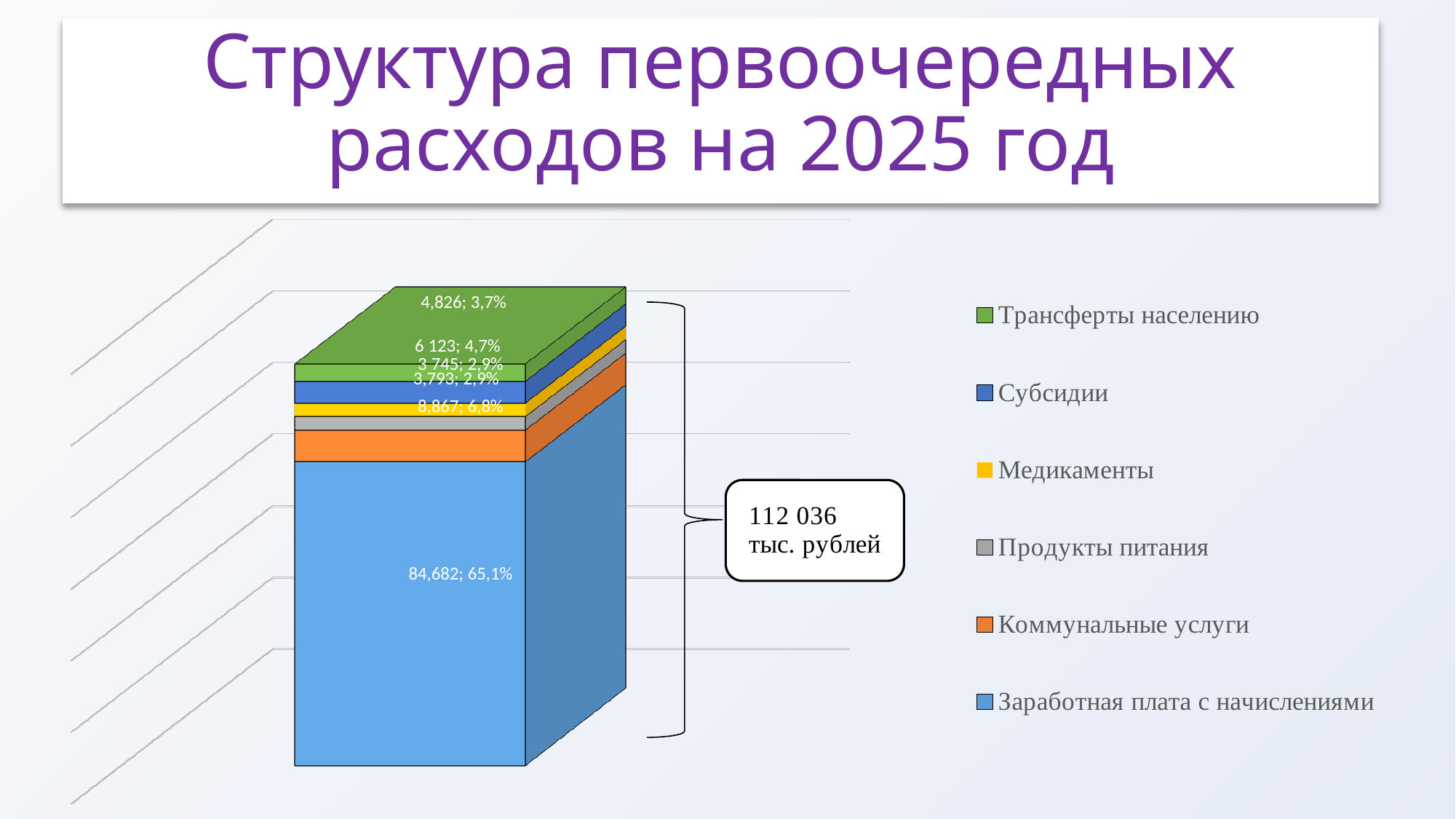
What is the value for Заработная плата с начислениями? 84,682 What percentage share is shown for Заработная плата с начислениями? 65,1% Which colour represents Медикаменты in the legend? Yellow What is the total of the stacked bar, as shown in the callout? 112 036 тыс. рублей Which category has the largest value? Заработная плата с начислениями Which is larger, Коммунальные услуги or Субсидии? Коммунальные услуги What is the difference between the values for Коммунальные услуги and Трансферты населению? 4,041 What is the value for Коммунальные услуги? 8,867 What percentage share is shown for Субсидии? 4,7% What is the value for Трансферты населению? 4,826 What kind of chart is shown on the slide? Stacked bar chart How many series does the legend list? 6